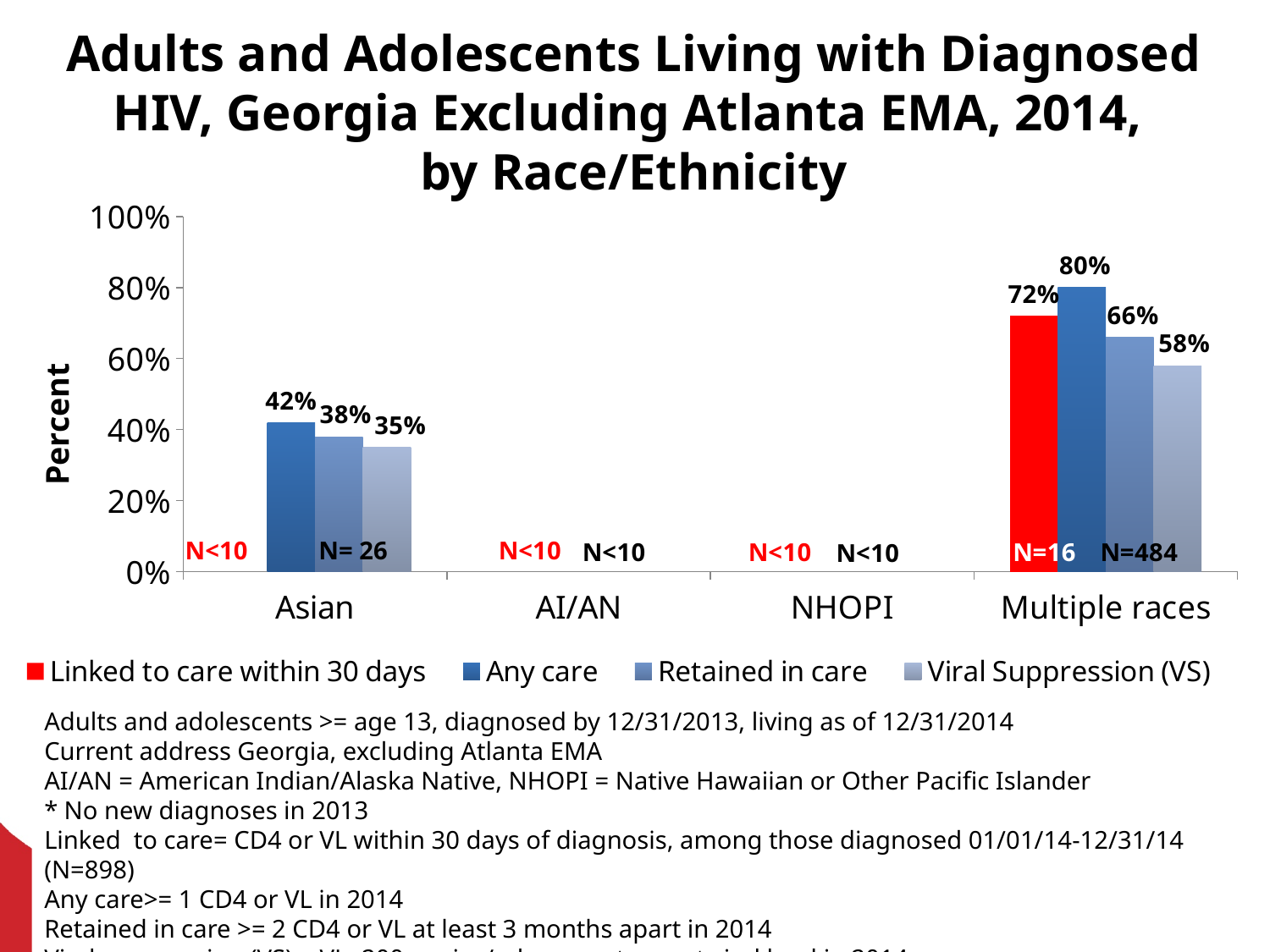
Which is larger: the Retained in care value for Multiple races or the Any care value for Asian? Retained in care for Multiple races How many race/ethnicity categories are shown on the x axis? 4 What is the Linked to care within 30 days value for Multiple races? 72% What is the difference between the Any care and Viral Suppression (VS) values for Multiple races? 22% How many series does the legend list? 4 What kind of chart is shown on the slide? Bar chart What is the N shown for the Any care bar for Multiple races? N=484 What is the Viral Suppression (VS) value for Asian? 35% Which race/ethnicity category has the highest Any care value? Multiple races What is the Retained in care value for Asian? 38% What is the difference between the Any care values for Multiple races and Asian? 38% What is the Any care value for Multiple races? 80%